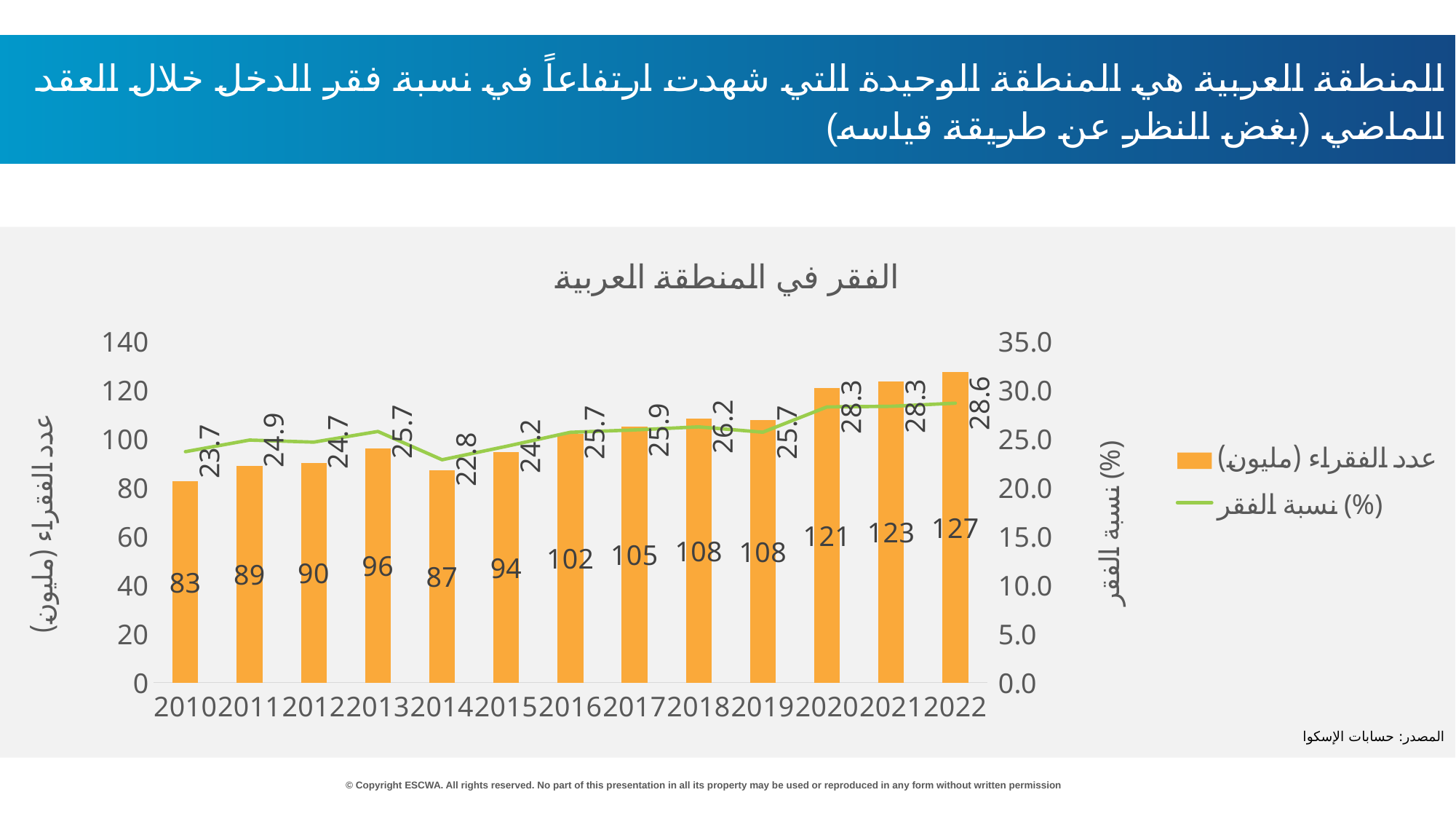
How many years are shown on the x axis of the chart? 13 What is the difference in the number of poor (عدد الفقراء (مليون)) between 2022 and 2010? 44 Which year has the highest number of poor (عدد الفقراء (مليون))? 2022 Does the number of poor (عدد الفقراء (مليون)) generally rise or fall from 2010 to 2022? Rise Which year has the lowest poverty rate (نسبة الفقر (%))? 2014 What is the poverty rate (نسبة الفقر (%)) shown for 2014? 22.8 What kind of chart is shown on the slide? Combined bar and line chart Which year has the larger number of poor (عدد الفقراء (مليون)), 2013 or 2015? 2013 What is the number of poor (عدد الفقراء (مليون)) shown for 2010? 83 What is the title of the chart? الفقر في المنطقة العربية What is the number of poor (عدد الفقراء (مليون)) shown for 2022? 127 How many series does the chart legend list? 2